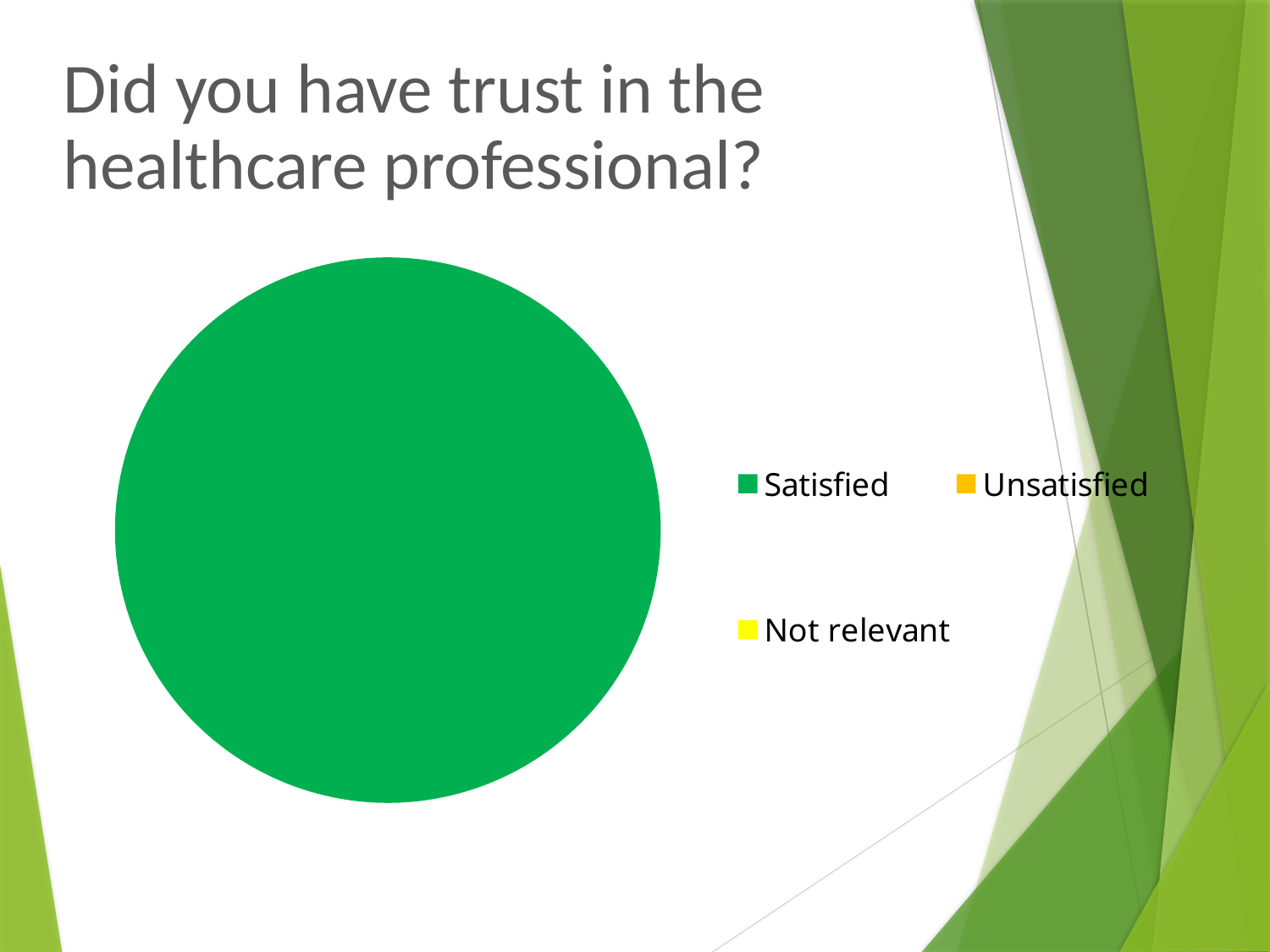
How many entries does the legend of the pie chart list? 3 Which is larger in the pie chart, the slice for Satisfied or the slice for Not relevant? Satisfied Which category has the largest slice of the pie chart? Satisfied What colour represents the Satisfied category in the pie chart? Green What kind of chart is shown on the slide? Pie chart Which is larger in the pie chart, the slice for Satisfied or the slice for Unsatisfied? Satisfied What is the title of the slide containing the pie chart? Did you have trust in the healthcare professional?